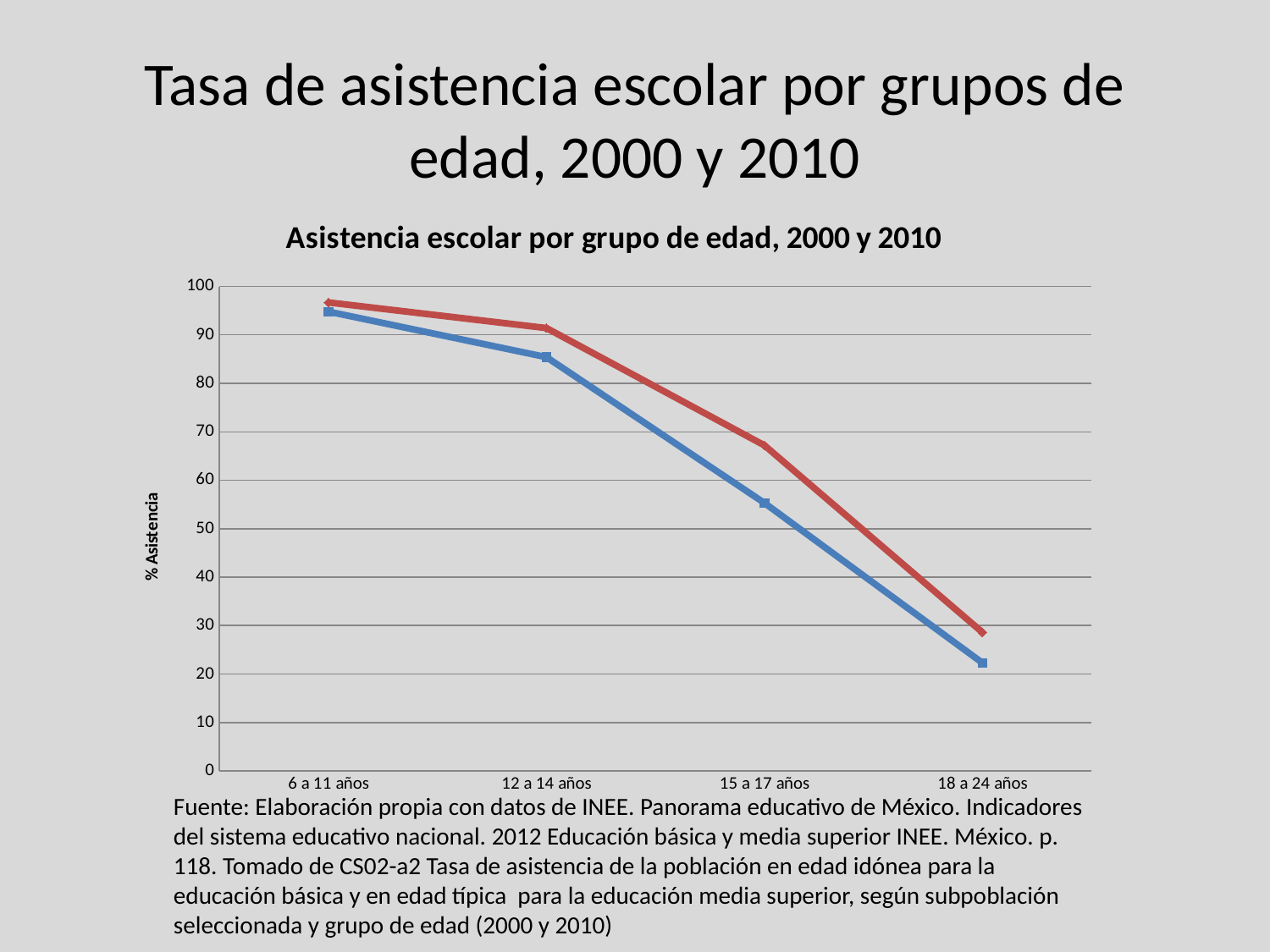
How many age-group categories are shown on the x axis? 4 How many lines are plotted on the chart? 2 Is the value of the blue line for '12 a 14 años' greater or less than 80? greater What is the title of the chart? Asistencia escolar por grupo de edad, 2000 y 2010 Which age group has the lowest value on the blue line? 18 a 24 años At '15 a 17 años', which line has the larger value, the red line or the blue line? red line Is the value of the blue line for '15 a 17 años' greater or less than 50? greater Is the value of the red line for '18 a 24 años' greater or less than 30? less What kind of chart is shown on the slide? line chart What is the label of the vertical axis? % Asistencia Which age group has the highest value on the red line? 6 a 11 años Do the values of the blue line rise or fall as you move from '6 a 11 años' to '18 a 24 años'? fall